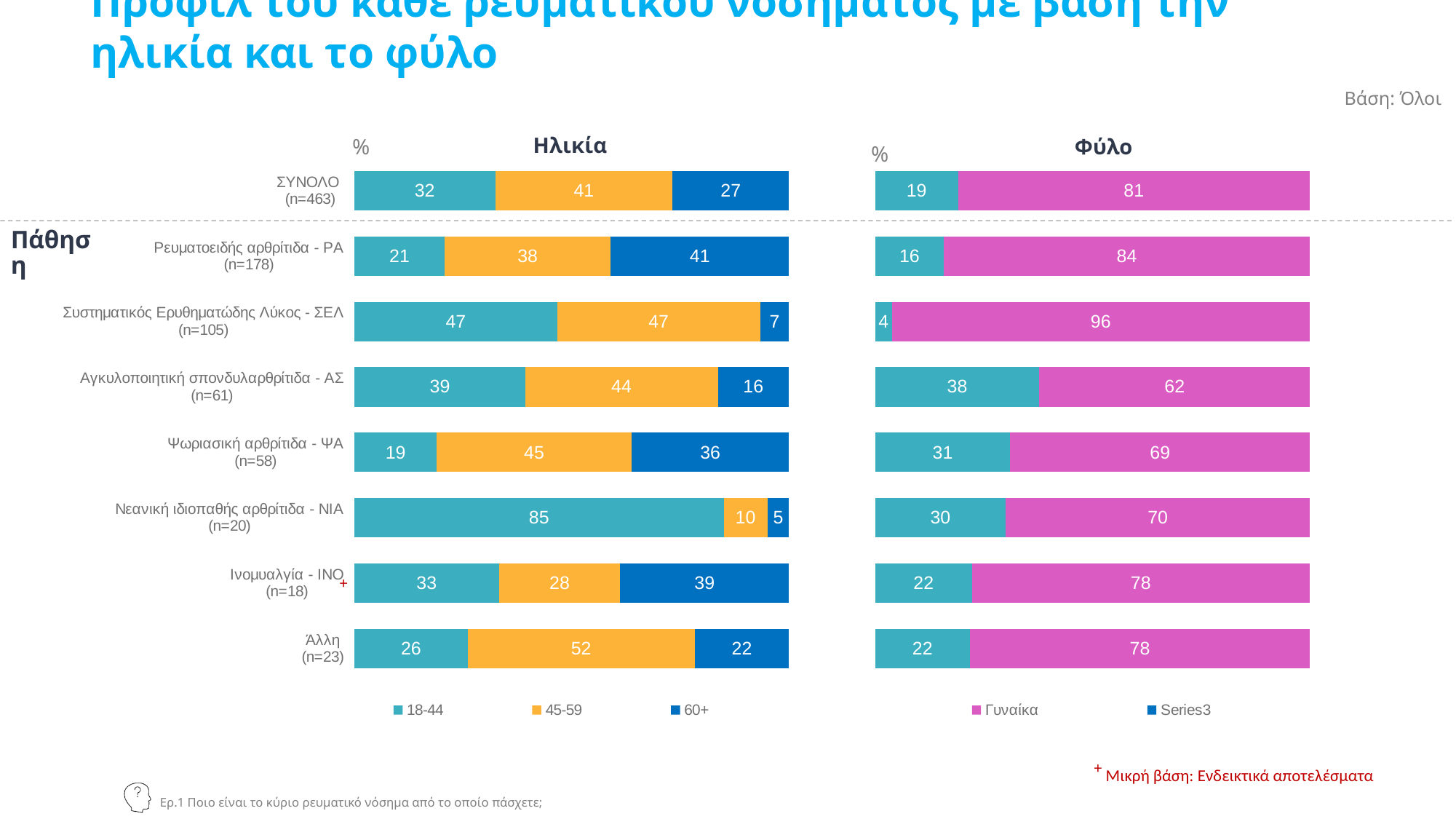
In the Ηλικία chart, what is the value of the 18-44 segment for Νεανική ιδιοπαθής αρθρίτιδα - ΝΙΑ? 85 What type of chart is the Φύλο chart? Stacked bar chart In the Ηλικία chart, what is the value of the 60+ segment for Ρευματοειδής αρθρίτιδα - ΡΑ? 41 How many categories (rows) are shown in the Ηλικία chart? 8 In the Ηλικία chart, what is the difference between the 60+ values for Ψωριασική αρθρίτιδα - ΨΑ and Αγκυλοποιητική σπονδυλαρθρίτιδα - ΑΣ? 20 In the Ηλικία chart, what is the total of the stacked bar for ΣΥΝΟΛΟ (n=463)? 100 In the Φύλο chart, what is the value of the Γυναίκα segment for Συστηματικός Ερυθηματώδης Λύκος - ΣΕΛ? 96 In the Ηλικία chart, which category has the highest value for the 45-59 segment? Άλλη In the Φύλο chart, is the Γυναίκα value larger for Ρευματοειδής αρθρίτιδα - ΡΑ or for Ψωριασική αρθρίτιδα - ΨΑ? Ρευματοειδής αρθρίτιδα - ΡΑ In the Ηλικία chart, which category has the lowest value for the 60+ segment? Νεανική ιδιοπαθής αρθρίτιδα - ΝΙΑ In the Φύλο chart, which category has the lowest Γυναίκα value? Αγκυλοποιητική σπονδυλαρθρίτιδα - ΑΣ How many series does the legend of the Ηλικία chart list? 3